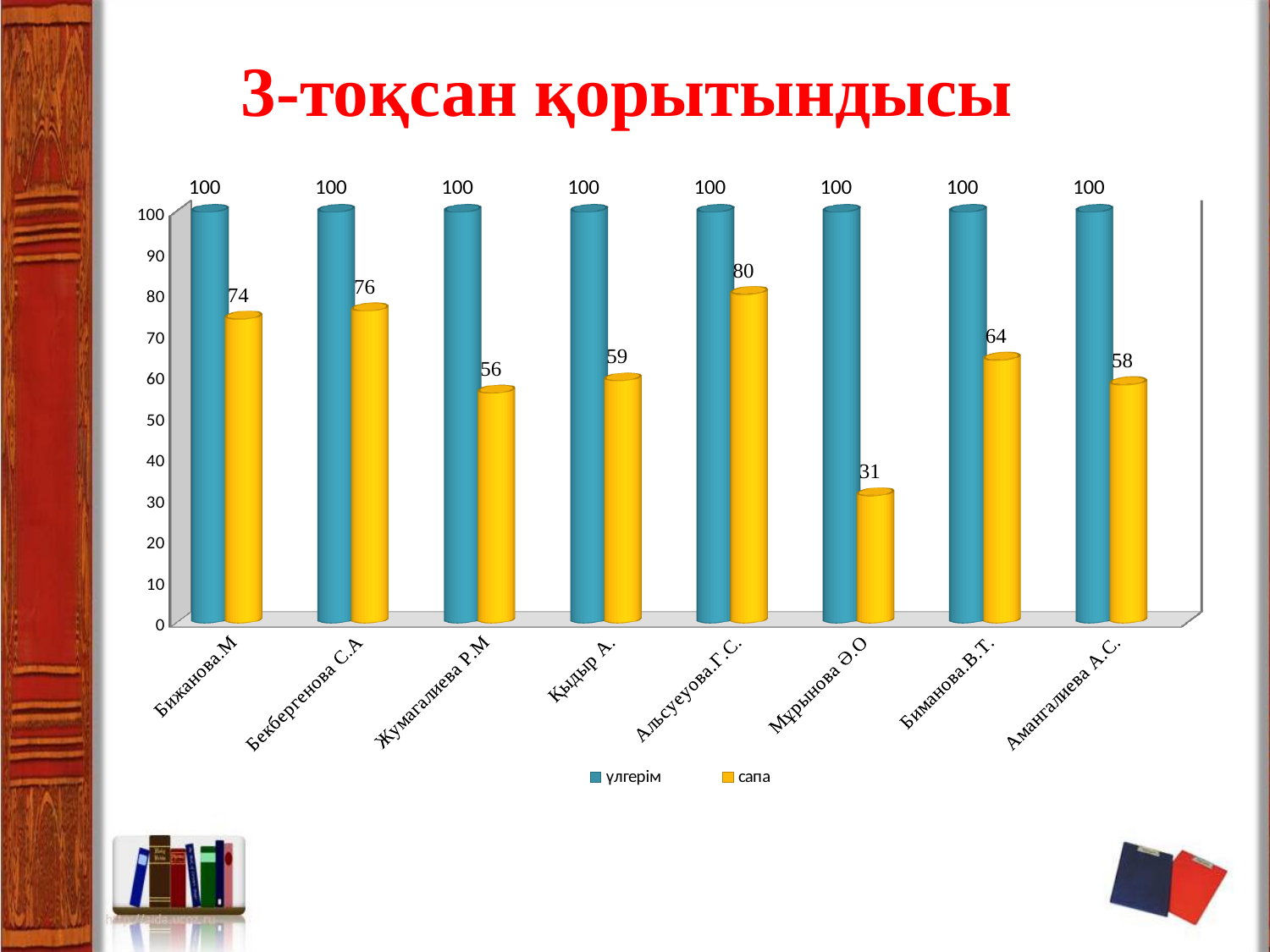
Which category has the highest сапа value? Альсуеуова.Г.С. What is the үлгерім value for Қыдыр А.? 100 What is the difference between the сапа values for Бекбергенова С.А and Жумагалиева Р.М? 20 What is the сапа value for Бижанова.М? 74 Which category has the lowest сапа value? Мұрынова Ә.О What kind of chart is shown on the slide? bar chart What is the сапа value for Мұрынова Ә.О? 31 Which has a larger сапа value, Биманова.В.Т. or Амангалиева А.С.? Биманова.В.Т. What is the title of the slide? 3-тоқсан қорытындысы How many categories are shown on the x axis? 8 Which series is shown in yellow? сапа How many series does the legend list? 2